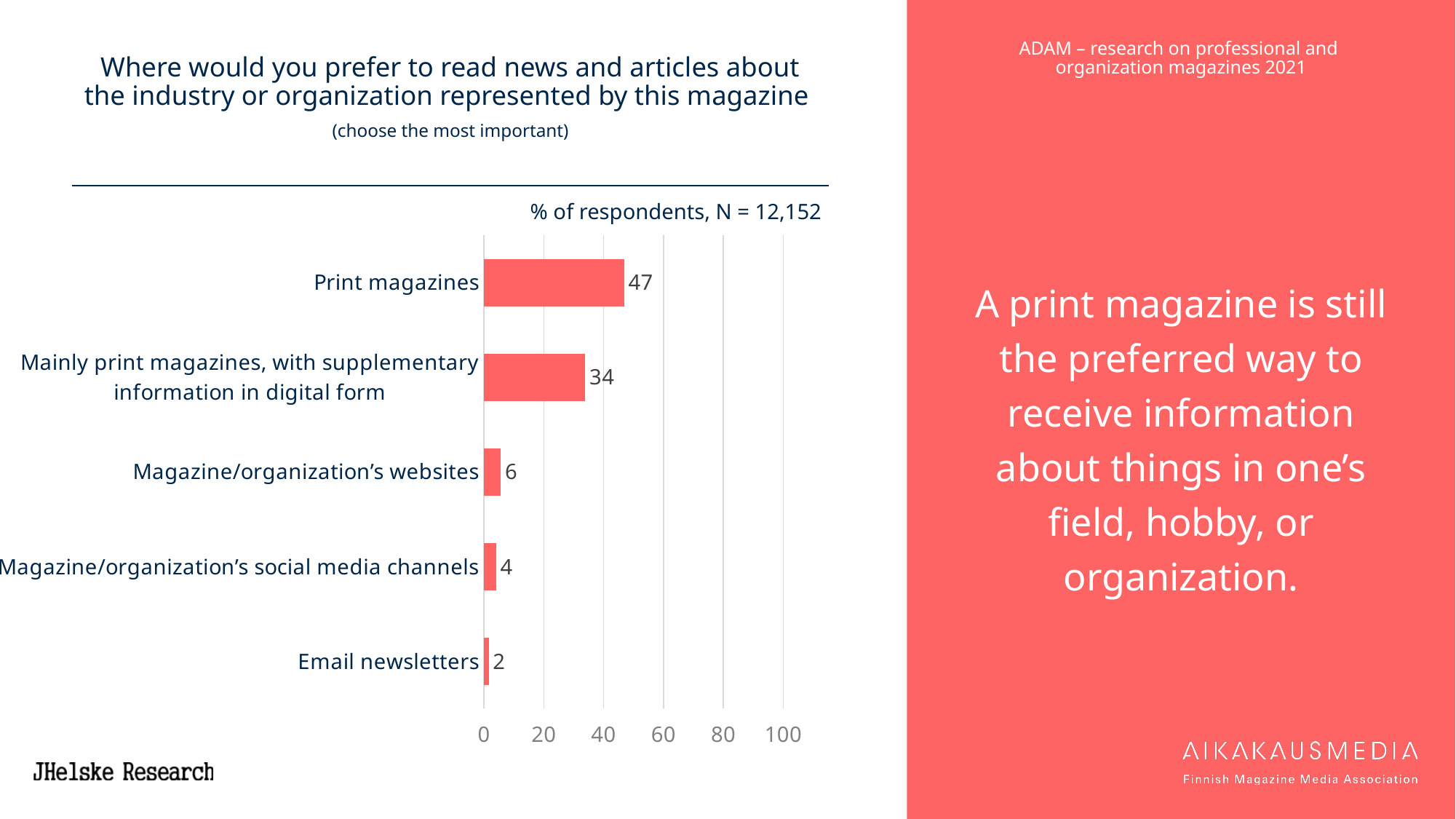
What percentage of respondents prefer print magazines? 47 What is the number of respondents (N) stated above the chart? 12,152 What is the value for 'Mainly print magazines, with supplementary information in digital form'? 34 What is the difference between the values for print magazines and mainly print magazines with supplementary digital information? 13 What percentage of respondents chose email newsletters? 2 How many categories are shown in the chart? 5 Which is larger: the value for magazine/organization's websites or for magazine/organization's social media channels? Magazine/organization's websites What is the difference between the values for magazine/organization's websites and email newsletters? 4 Which category has the highest value? Print magazines Is the value for print magazines greater or less than 40? greater What kind of chart is shown on the slide? Bar chart Which category has the lowest value? Email newsletters